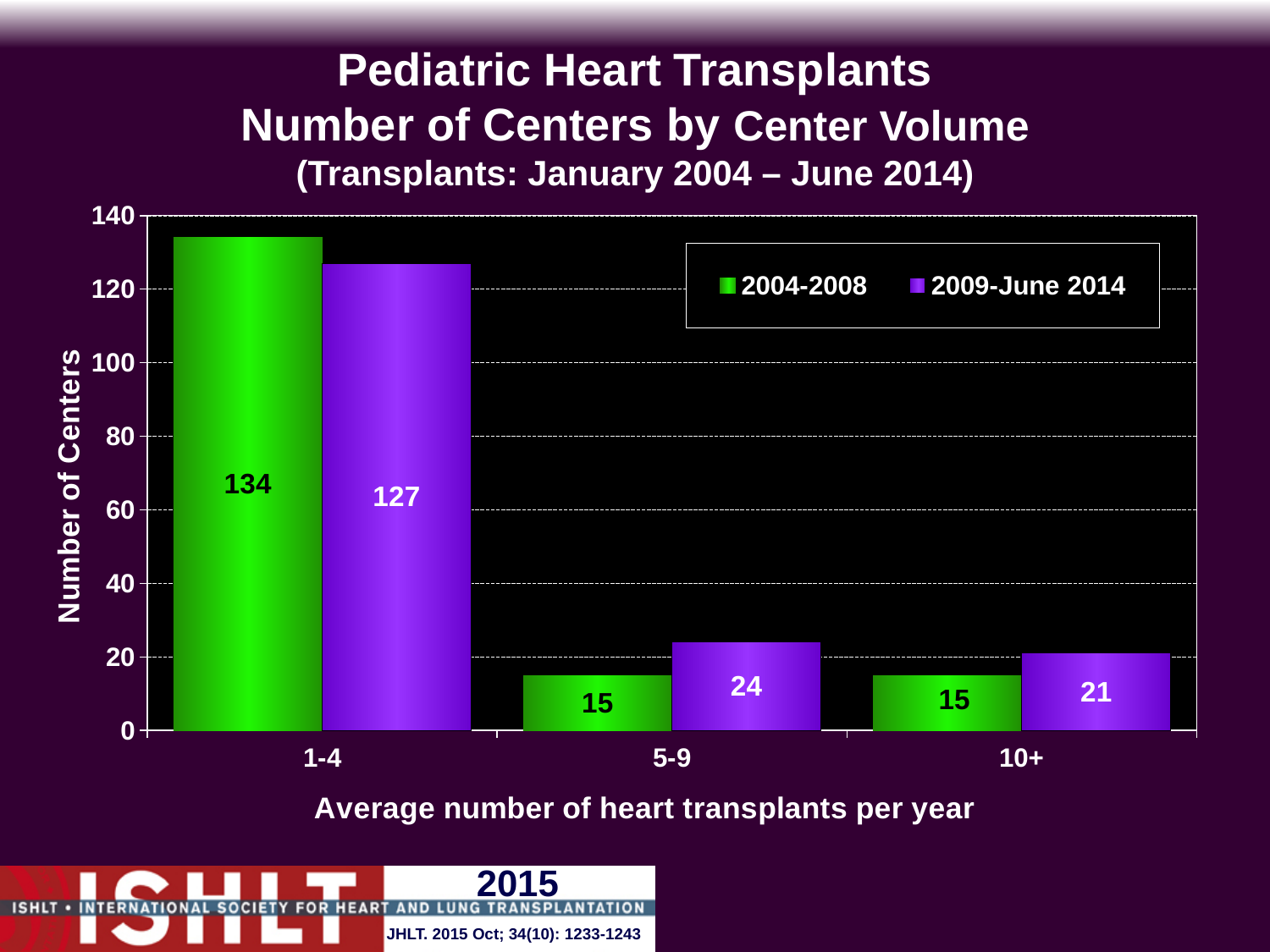
How many center volume categories are shown on the x axis? 3 What is the number of centers in the 10+ category for 2004-2008? 15 How many centers averaged 1-4 heart transplants per year in 2004-2008? 134 Is the 2009-June 2014 value for the 1-4 category greater or less than 120? greater What kind of chart is shown on the slide? Bar chart How many centers averaged 5-9 heart transplants per year in 2009-June 2014? 24 What is the difference between the 2004-2008 and 2009-June 2014 values for the 1-4 category? 7 For the 10+ category, which period has more centers, 2004-2008 or 2009-June 2014? 2009-June 2014 Which center volume category has the highest number of centers for 2009-June 2014? 1-4 Which center volume category has the lowest number of centers for 2009-June 2014? 10+ What is the label of the y axis? Number of Centers How many series does the legend list? 2